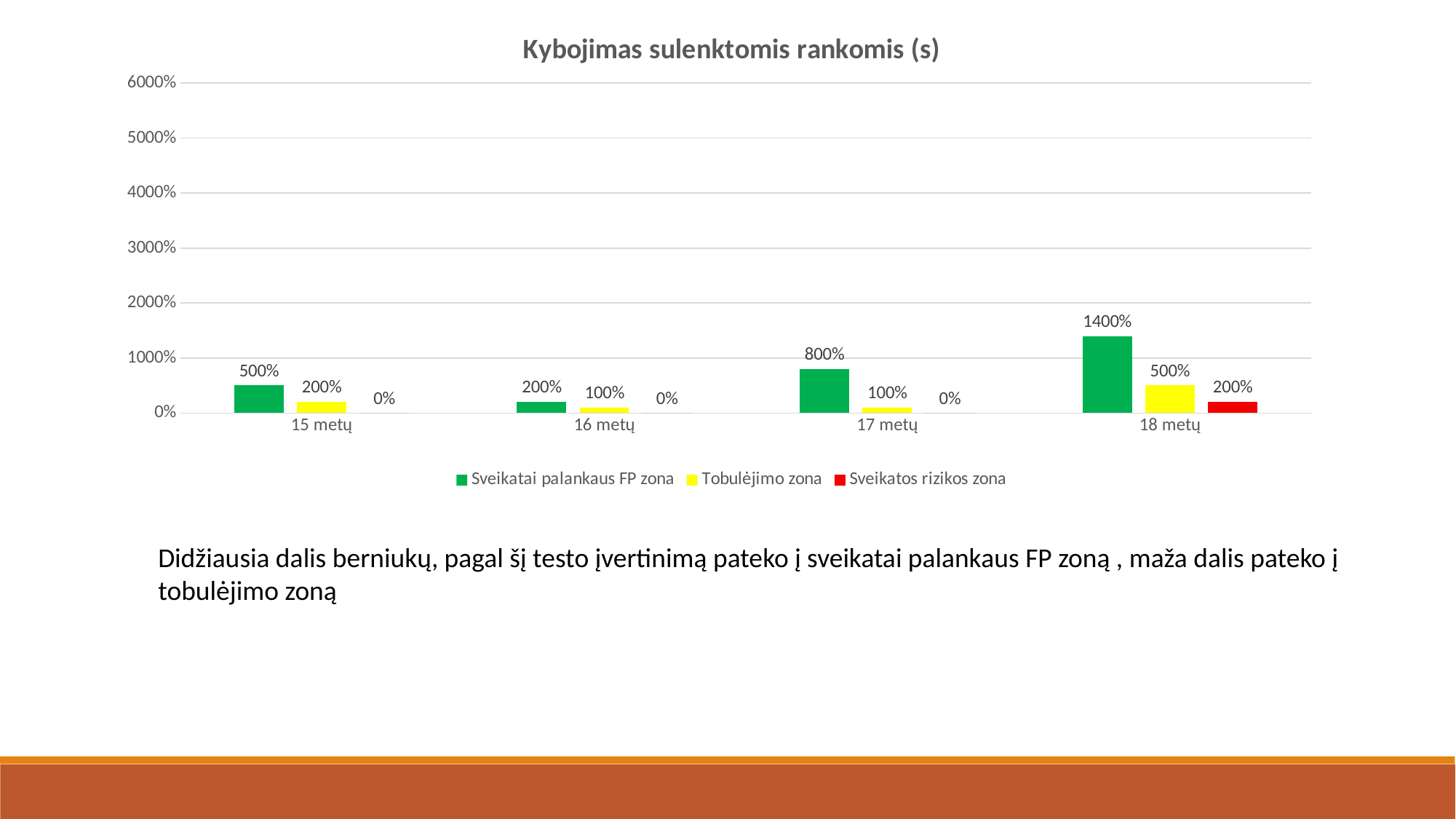
What kind of chart is shown? bar chart Which is larger: Tobulėjimo zona at 18 metų or Tobulėjimo zona at 16 metų? Tobulėjimo zona at 18 metų What is the value for Sveikatai palankaus FP zona at 17 metų? 800% What is the difference between the Sveikatai palankaus FP zona values at 18 metų and 17 metų? 600% Which age group has the lowest value for Sveikatai palankaus FP zona? 16 metų How many series does the legend list? 3 What is the value for Tobulėjimo zona at 15 metų? 200% What is the value for Sveikatai palankaus FP zona at 18 metų? 1400% What is the title of the chart? Kybojimas sulenktomis rankomis (s) Which age group has the highest value for Sveikatai palankaus FP zona? 18 metų What is the value for Sveikatos rizikos zona at 18 metų? 200% How many age groups are shown on the x axis? 4